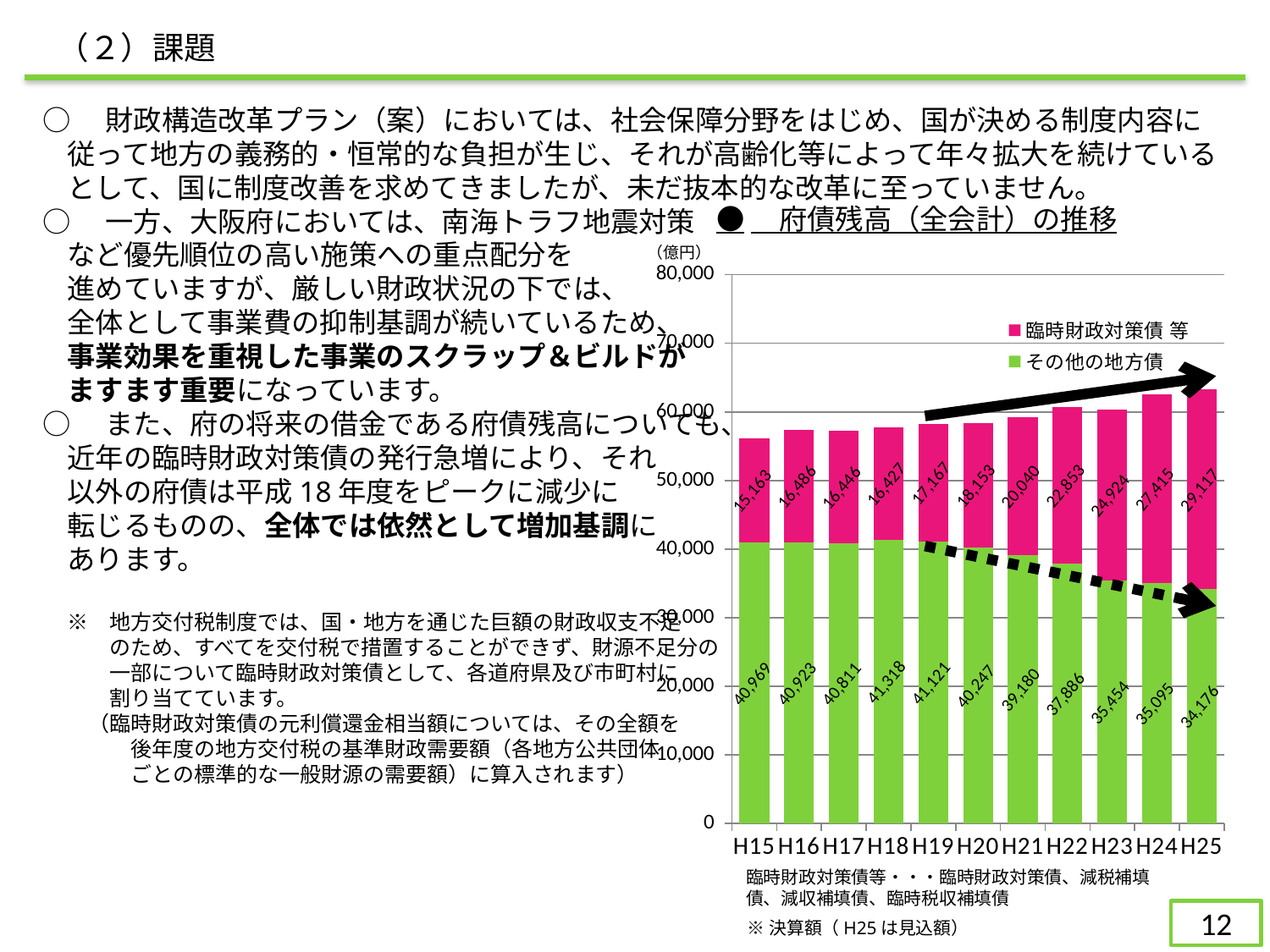
H18のその他の地方債の値はいくらですか？ 41,318 凡例にはいくつの系列が示されていますか？ 2 臨時財政対策債 等が最も少ない年度はどれですか？ H15 その他の地方債が最も多い年度はどれですか？ H18 臨時財政対策債 等の値はH15からH25にかけて増加していますか、減少していますか？ 増加 H25の臨時財政対策債 等の値はいくらですか？ 29,117 H25の臨時財政対策債 等はH15と比べていくら増えていますか？ 13,954 グラフのタイトルは何ですか？ 府債残高（全会計）の推移 H15とH25では、その他の地方債はどちらが大きいですか？ H15 このグラフはどの種類のグラフですか？ 積み上げ棒グラフ H25の府債残高の合計（臨時財政対策債 等とその他の地方債の合計）はいくらですか？ 63,293 横軸にはいくつの年度（カテゴリ）がありますか？ 11